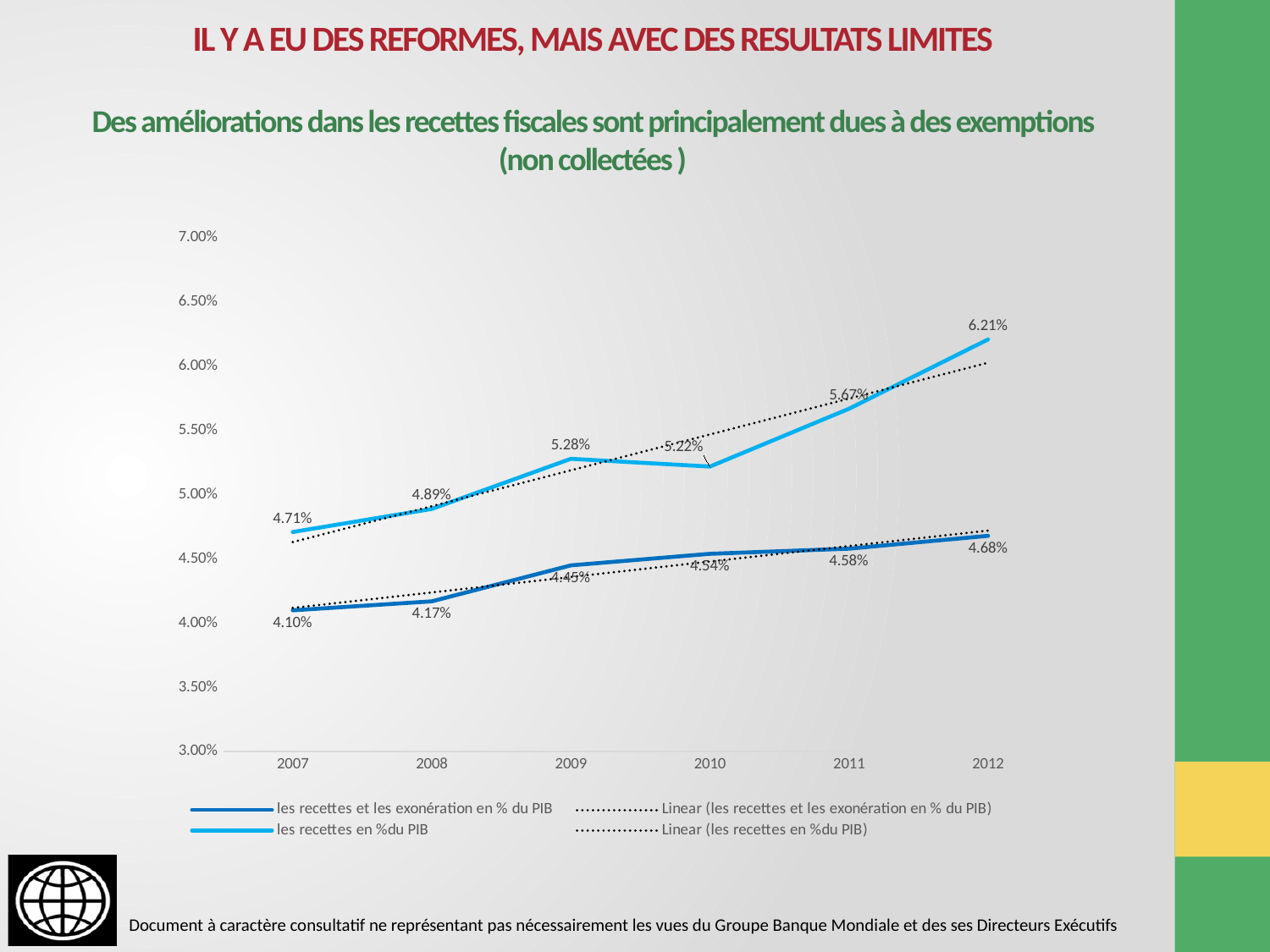
What kind of chart is shown on the slide? line chart How many years are plotted along the x axis of the chart? 6 How many entries does the chart legend list? 4 Does 'les recettes et les exonération en % du PIB' rise or fall from 2007 to 2012? rise What is the value of 'les recettes en %du PIB' in 2009? 5.28% In which year is 'les recettes et les exonération en % du PIB' at its lowest? 2007 Which is larger for 'les recettes en %du PIB': the 2009 value or the 2010 value? 2009 What is the difference between the two plotted series in 2012 (6.21% and 4.68%)? 1.53% In which year does 'les recettes en %du PIB' reach its highest value? 2012 Is the 2010 value of 'les recettes et les exonération en % du PIB' greater or less than 5.00%? less What is the value of 'les recettes et les exonération en % du PIB' in 2007? 4.10% What is the value of 'les recettes en %du PIB' in 2012? 6.21%